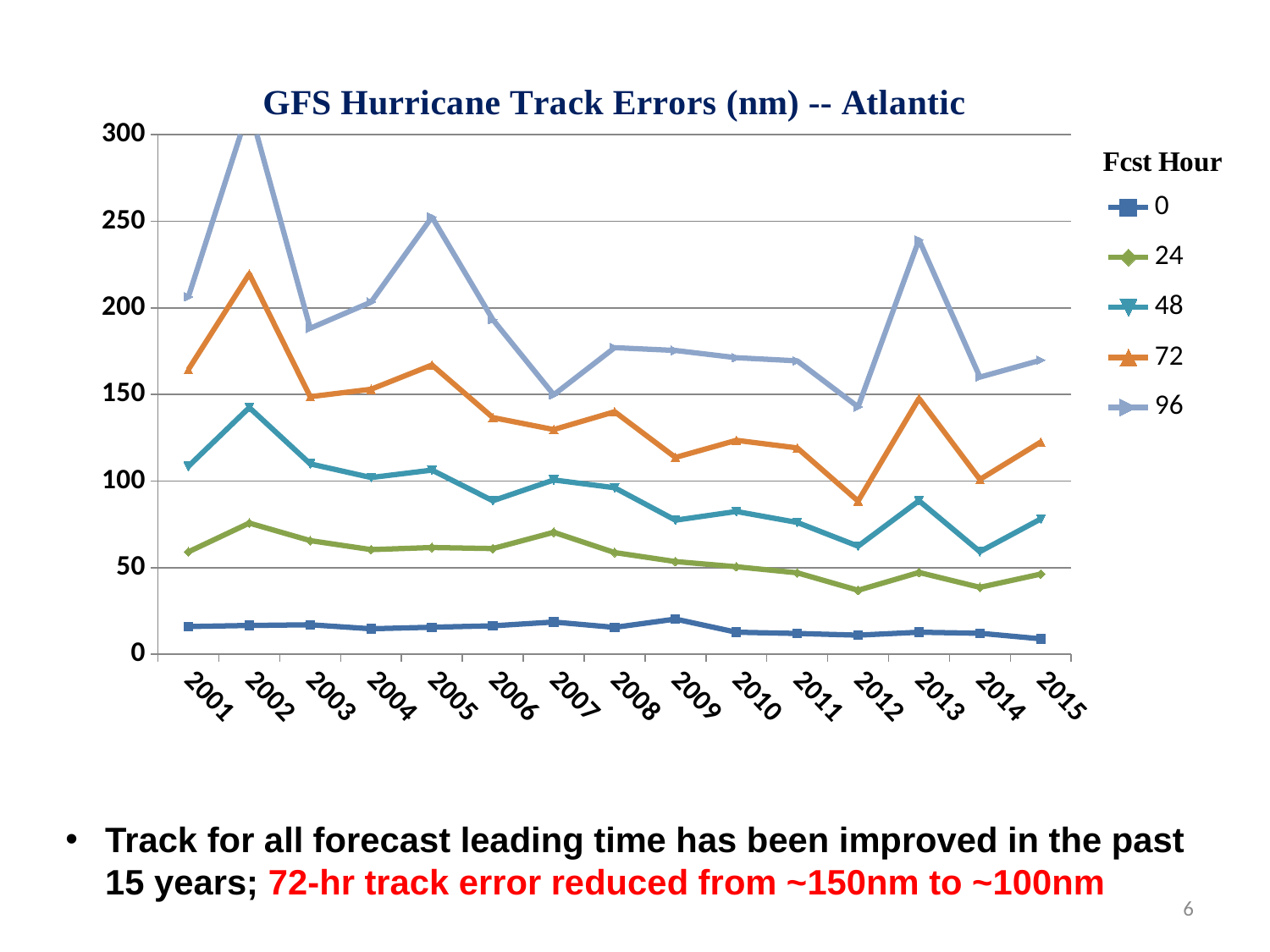
What kind of chart is shown on the slide? line chart In which year is the 72-hour track error lowest? 2012 Is the 48-hour track error in 2012 greater or less than 100? less Does the 24-hour track error generally rise or fall from 2001 to 2015? fall In which year is the 24-hour track error highest? 2002 Is the 96-hour track error in 2013 greater or less than 200? greater Which is larger, the 72-hour track error in 2013 or in 2014? 2013 In which year is the 96-hour track error highest? 2002 How many years are plotted along the x axis? 15 In which year is the 0-hour track error lowest? 2015 How many series does the legend list? 5 Is the 72-hour track error in 2002 greater or less than 200? greater